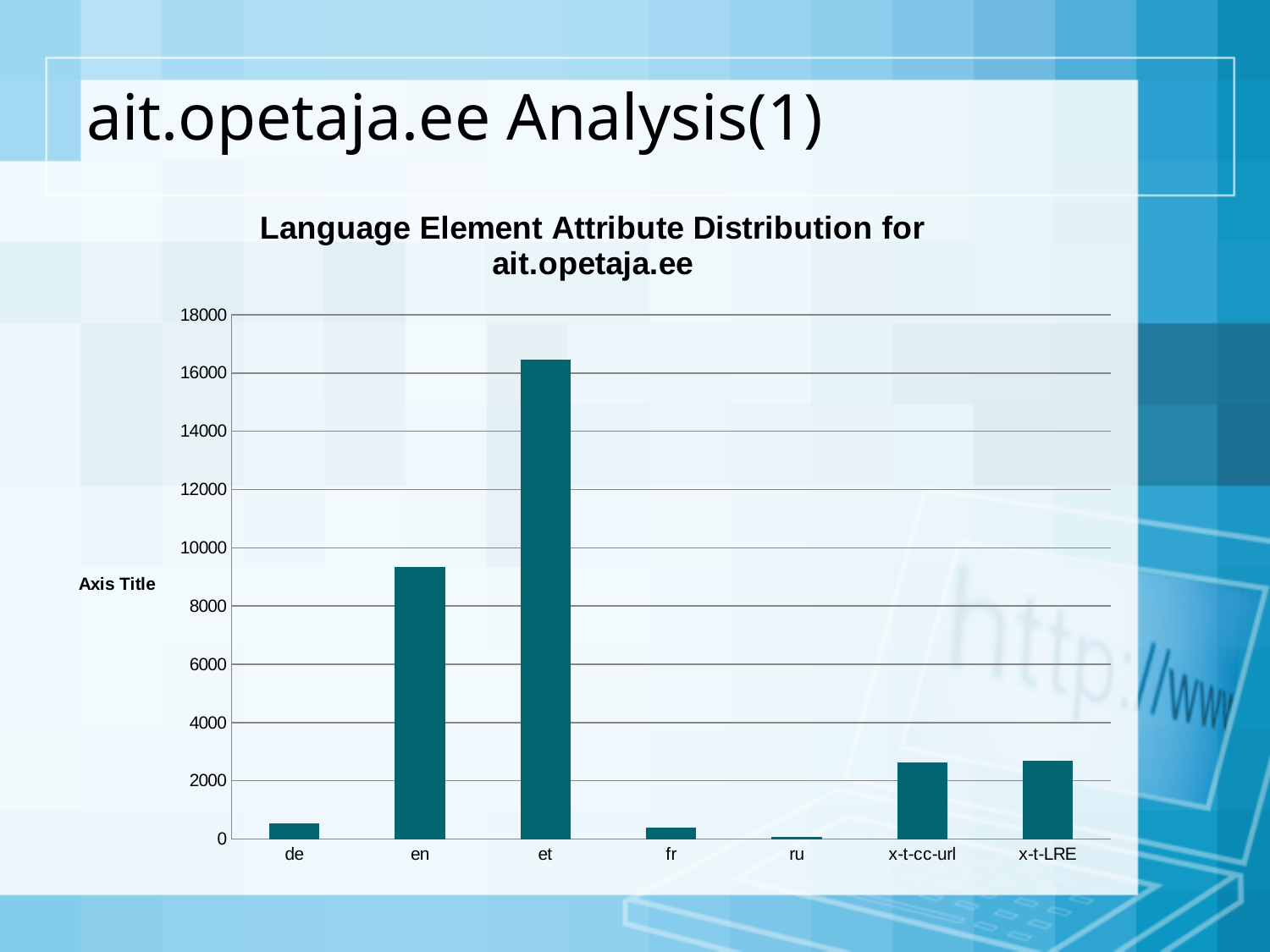
Which category has the lowest value in the chart? ru Which has a larger value, de or x-t-LRE? x-t-LRE What type of chart is shown on the slide? bar chart Is the value for en greater or less than 10000? less How many categories are shown on the x axis of the chart? 7 Which has a larger value, en or et? et Is the value for en greater or less than 8000? greater Which category has the highest value in the chart? et Is the value for de greater or less than 2000? less What is the title of the chart? Language Element Attribute Distribution for ait.opetaja.ee